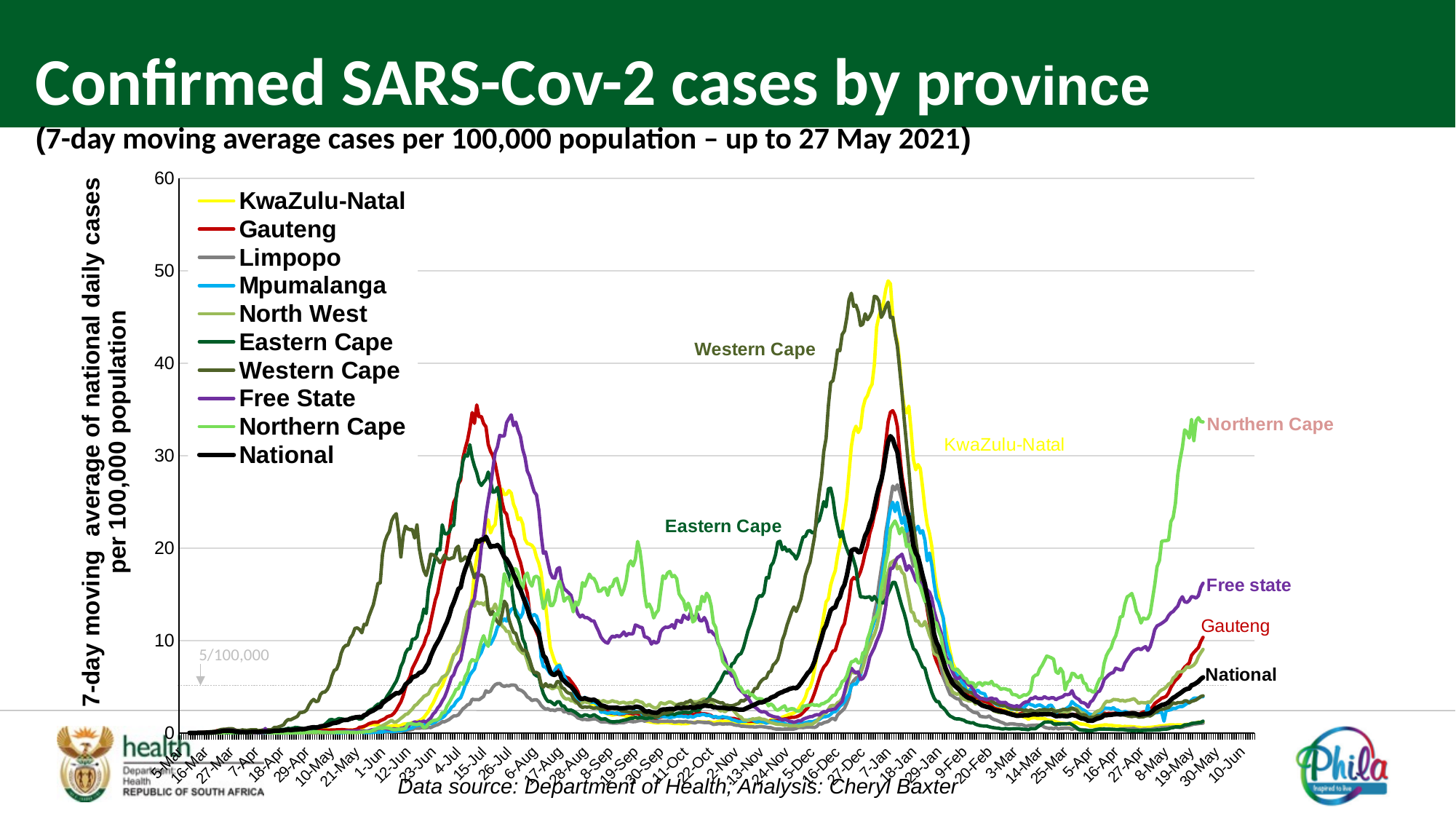
Is the value for Northern Cape at the end of May 2021 greater or less than 30? greater Which series reached a higher peak, KwaZulu-Natal or Gauteng? KwaZulu-Natal Is the peak value for KwaZulu-Natal greater or less than 40? greater Is the value for National at the end of May 2021 greater or less than 10? less Does the Northern Cape line rise or fall between 27-Apr and 19-May? rise How many series does the legend list? 10 According to the note below the chart, what is the data source? Department of Health Which series is drawn as the black line? National What kind of chart is shown on the slide? line chart Which series reached a higher peak in December/January, Western Cape or Gauteng? Western Cape